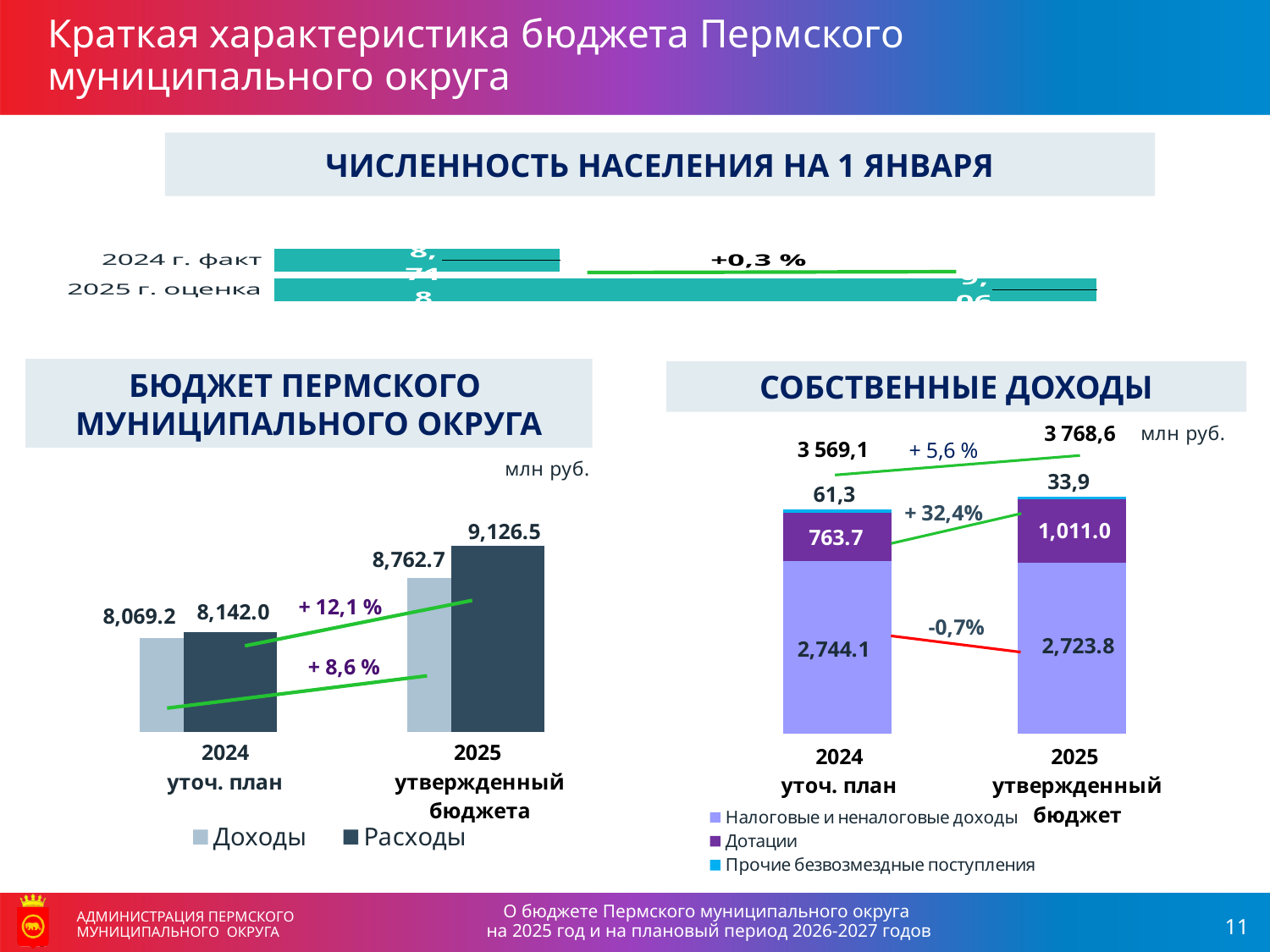
What kind of chart is the 'СОБСТВЕННЫЕ ДОХОДЫ' chart? stacked bar chart On the 'СОБСТВЕННЫЕ ДОХОДЫ' chart, do the values of Налоговые и неналоговые доходы rise or fall from 2024 to 2025? fall On the 'БЮДЖЕТ ПЕРМСКОГО МУНИЦИПАЛЬНОГО ОКРУГА' chart, which is larger for 2024 уточ. план: Доходы or Расходы? Расходы On the 'СОБСТВЕННЫЕ ДОХОДЫ' chart, what is the total of the stacked bar for 2025 утвержденный бюджет? 3 768,6 On the 'БЮДЖЕТ ПЕРМСКОГО МУНИЦИПАЛЬНОГО ОКРУГА' chart, what is the difference between Расходы and Доходы for 2025 утвержденный бюджета? 363.8 On the 'БЮДЖЕТ ПЕРМСКОГО МУНИЦИПАЛЬНОГО ОКРУГА' chart, what percentage growth is shown for Расходы from 2024 to 2025? + 12,1 % On the 'СОБСТВЕННЫЕ ДОХОДЫ' chart, what is the value of Налоговые и неналоговые доходы for 2024 уточ. план? 2,744.1 On the 'БЮДЖЕТ ПЕРМСКОГО МУНИЦИПАЛЬНОГО ОКРУГА' chart, what is the value of Доходы for 2024 уточ. план? 8,069.2 On the 'СОБСТВЕННЫЕ ДОХОДЫ' chart, what is the value of Дотации for 2025 утвержденный бюджет? 1,011.0 On the 'БЮДЖЕТ ПЕРМСКОГО МУНИЦИПАЛЬНОГО ОКРУГА' chart, what is the value of Расходы for 2025 утвержденный бюджета? 9,126.5 On the 'СОБСТВЕННЫЕ ДОХОДЫ' chart, how many series does the legend list? 3 On the 'БЮДЖЕТ ПЕРМСКОГО МУНИЦИПАЛЬНОГО ОКРУГА' chart, how many series does the legend list? 2